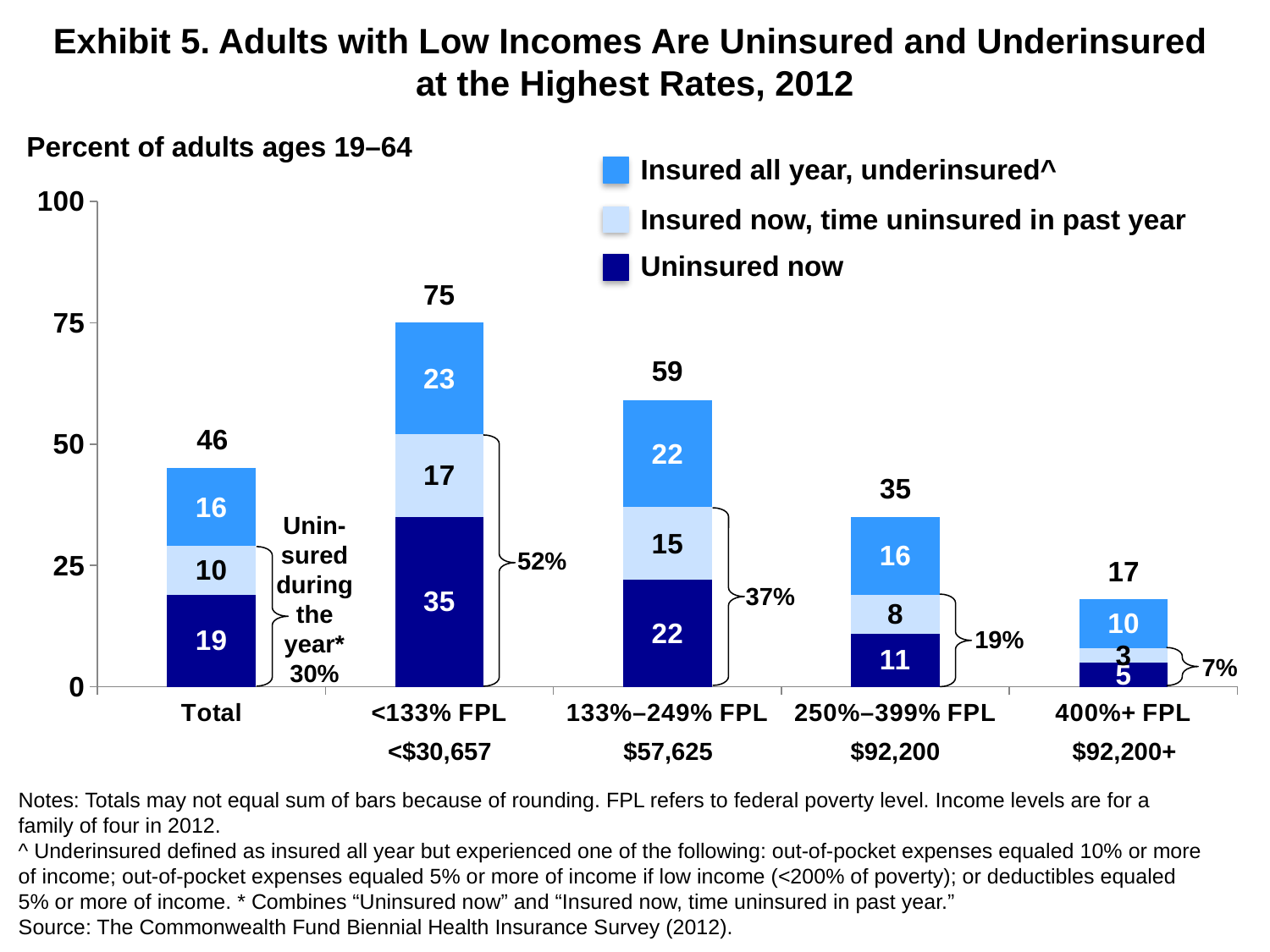
What is the 'Insured now, time uninsured in past year' value for the 250%–399% FPL group? 8 What percentage is labeled as uninsured during the year for the 133%–249% FPL group? 37% How many income categories are shown on the x axis? 5 What is the 'Uninsured now' value for the <133% FPL group? 35 Which is larger: the 'Uninsured now' value for Total or for 250%–399% FPL? Total Which income group has the highest total bar? <133% FPL How many series does the legend list? 3 Which income group has the lowest 'Uninsured now' value? 400%+ FPL What is the difference between the total for <133% FPL and the total for 133%–249% FPL? 16 What is the total labeled above the bar for the 400%+ FPL group? 17 What is the 'Insured all year, underinsured' value for the 133%–249% FPL group? 22 What kind of chart is shown on the slide? Stacked bar chart